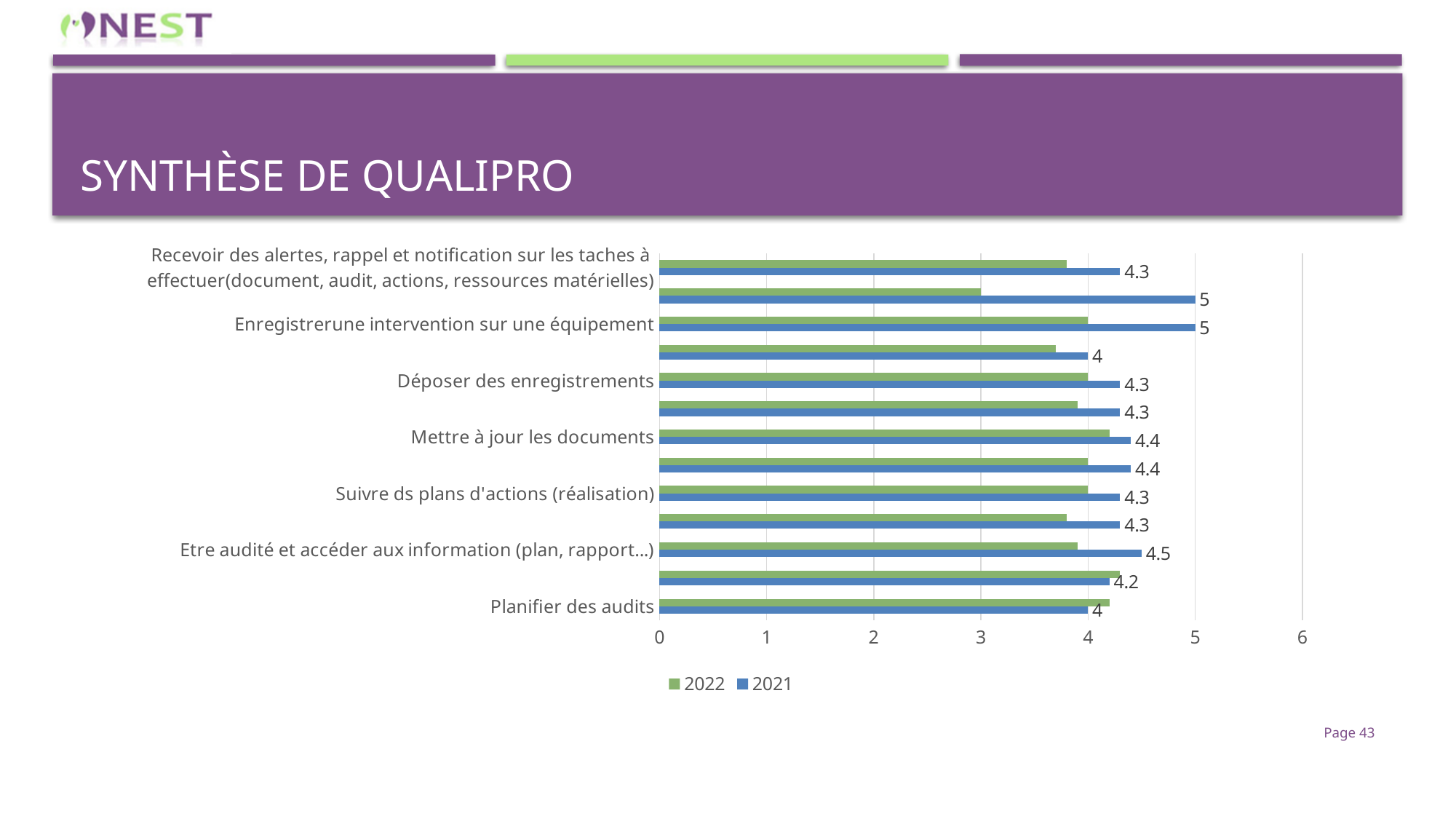
What is the difference between the 2021 values for 'Etre audité et accéder aux information (plan, rapport...)' and 'Planifier des audits'? 0.5 What is the difference between the 2021 values for 'Enregistrerune intervention sur une équipement' and 'Planifier des audits'? 1 What is the 2021 value for 'Mettre à jour les documents'? 4.4 What is the 2021 value for 'Déposer des enregistrements'? 4.3 What kind of chart is shown on the slide? bar chart Which entries does the legend list? 2022 and 2021 Is the 2022 value for 'Recevoir des alertes, rappel et notification sur les taches à effectuer' greater or less than 4? less What is the 2021 value for 'Enregistrerune intervention sur une équipement'? 5 What is the 2021 value for 'Etre audité et accéder aux information (plan, rapport...)'? 4.5 For 2021, which is larger: 'Enregistrerune intervention sur une équipement' or 'Planifier des audits'? Enregistrerune intervention sur une équipement What is the 2021 value for 'Planifier des audits'? 4 How many series does the legend list? 2